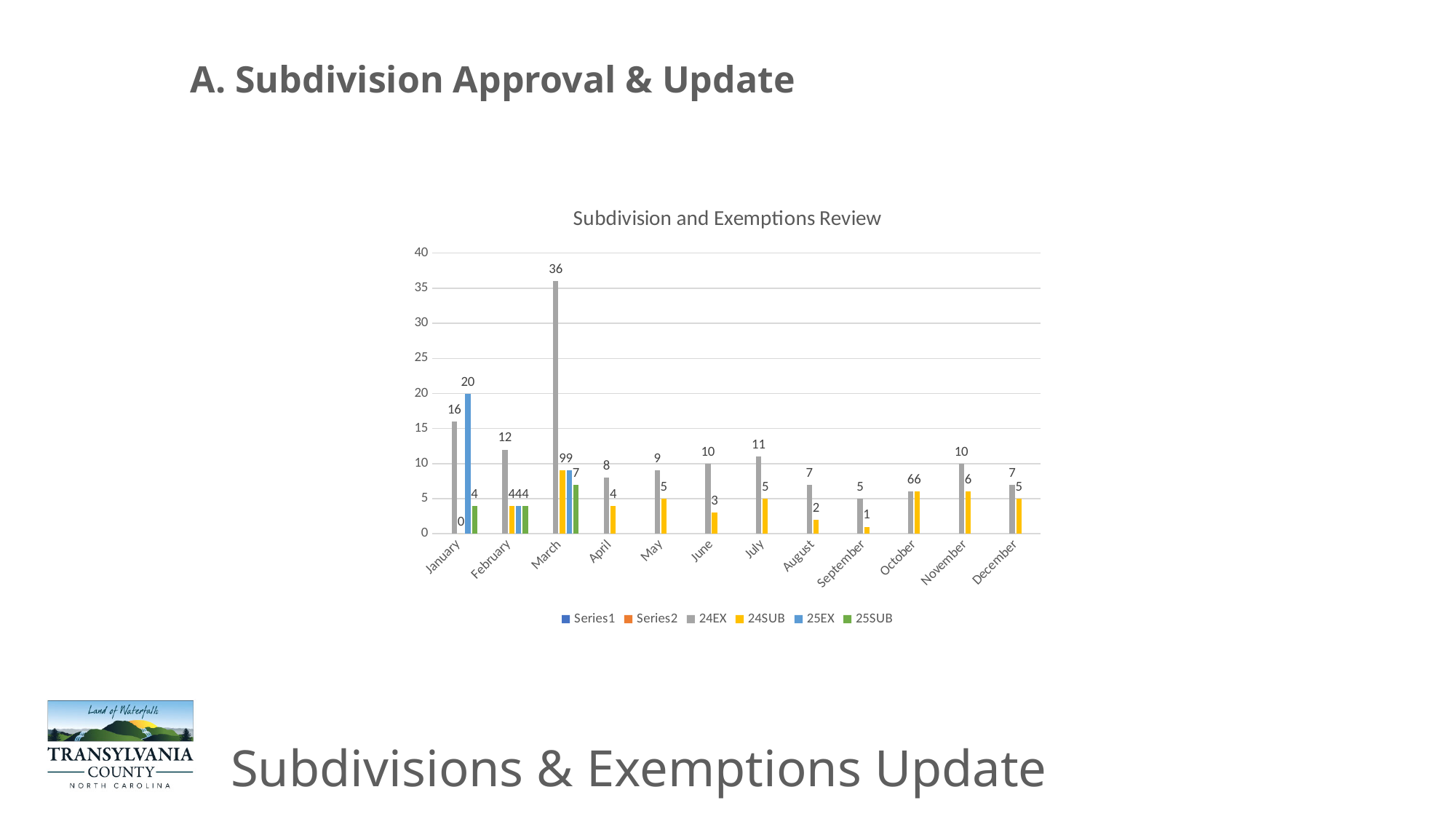
How many series does the legend list? 6 What is the title of the chart? Subdivision and Exemptions Review What is the value of 24EX for November? 10 What is the value of 24SUB for September? 1 Which month has the lowest 24SUB value? January What is the value of 24EX for March? 36 How many months are shown on the x axis? 12 Which is larger for January: the 24EX value or the 25EX value? 25EX What kind of chart is shown on the slide? Bar chart Which month has the highest 24EX value? March What is the value of 25EX for January? 20 What is the difference between the 24EX value for March and the 24EX value for February? 24